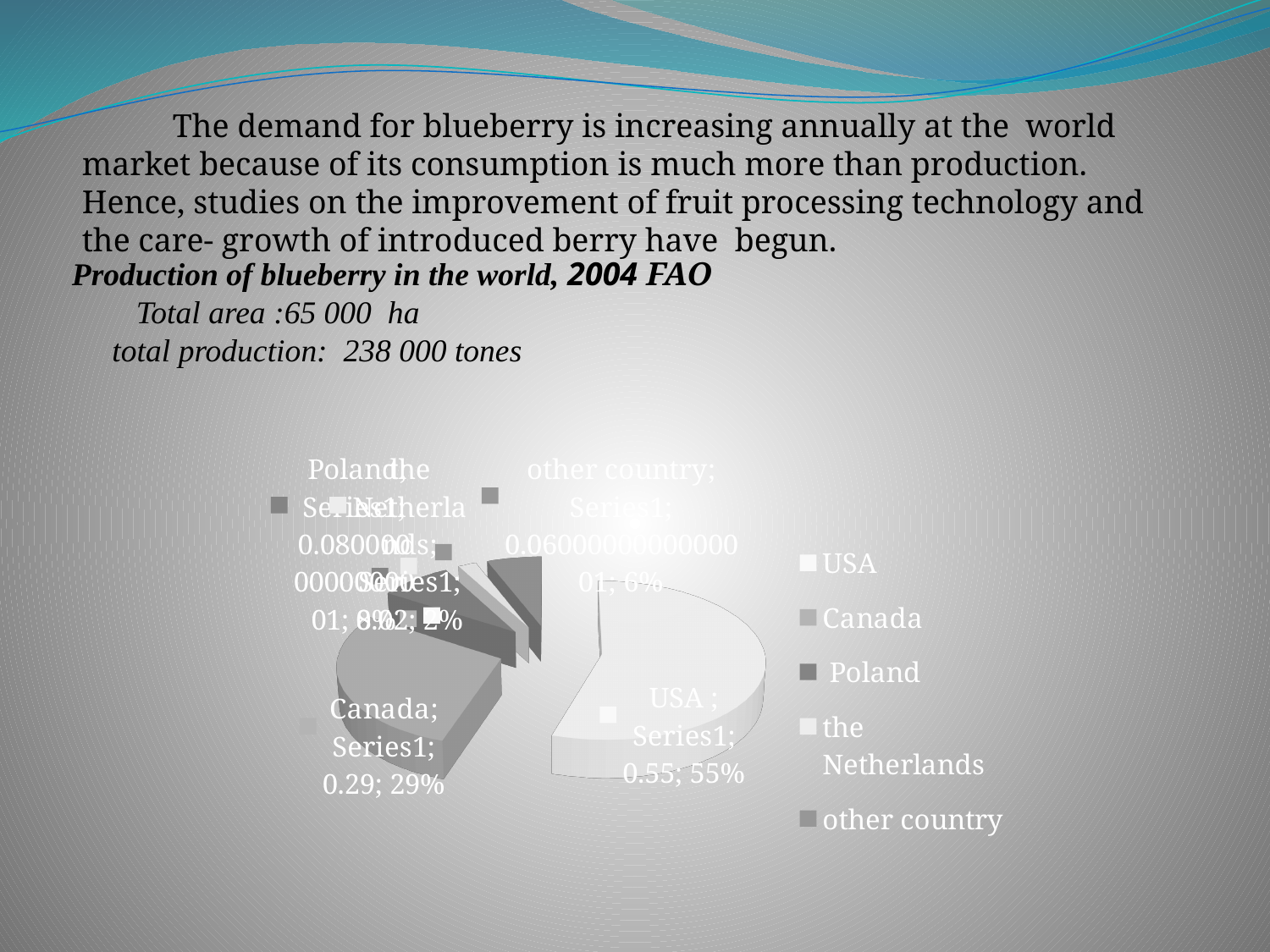
What kind of chart is shown on the slide? pie chart Which country has the largest slice of the pie? USA What is the difference in percentage points between the USA share and the Canada share? 26 Which category is listed last in the legend? other country Which category has the smallest slice of the pie? the Netherlands What share of the pie does Canada represent? 29% What share of world blueberry production does the USA slice represent? 55% What is the title given above the chart for the data it shows? Production of blueberry in the world, 2004 FAO How many categories does the legend list? 5 Which is larger, the USA slice or the Canada slice? USA What is the difference in percentage points between the Canada share and the 'other country' share? 23 What share of the pie does the 'other country' slice represent? 6%